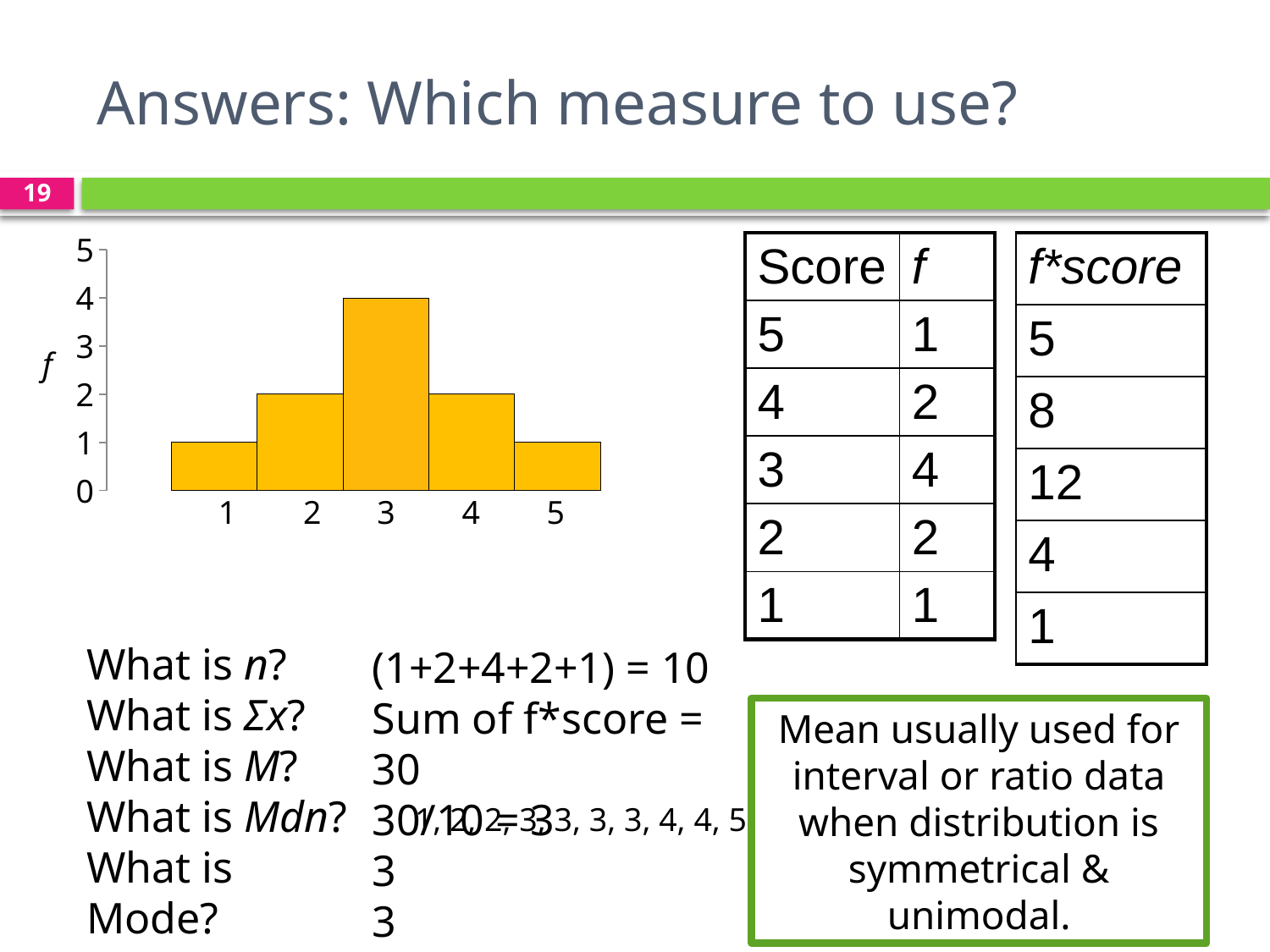
Which score has the highest frequency in the chart? 3 What is the difference between the frequency for score 3 and the frequency for score 2? 2 Is the frequency for score 3 greater or less than 3? greater What is the maximum value shown on the vertical axis of the chart? 5 What is the frequency (f) for score 1 in the chart? 1 What is the frequency (f) for score 3 in the chart? 4 What is the frequency (f) for score 4 in the chart? 2 What is the label on the vertical axis of the chart? f What type of chart is shown on the slide? bar chart How many bars are plotted in the chart? 5 Which has a larger frequency in the chart, score 2 or score 5? score 2 Do the bar heights rise or fall from score 3 to score 5? fall